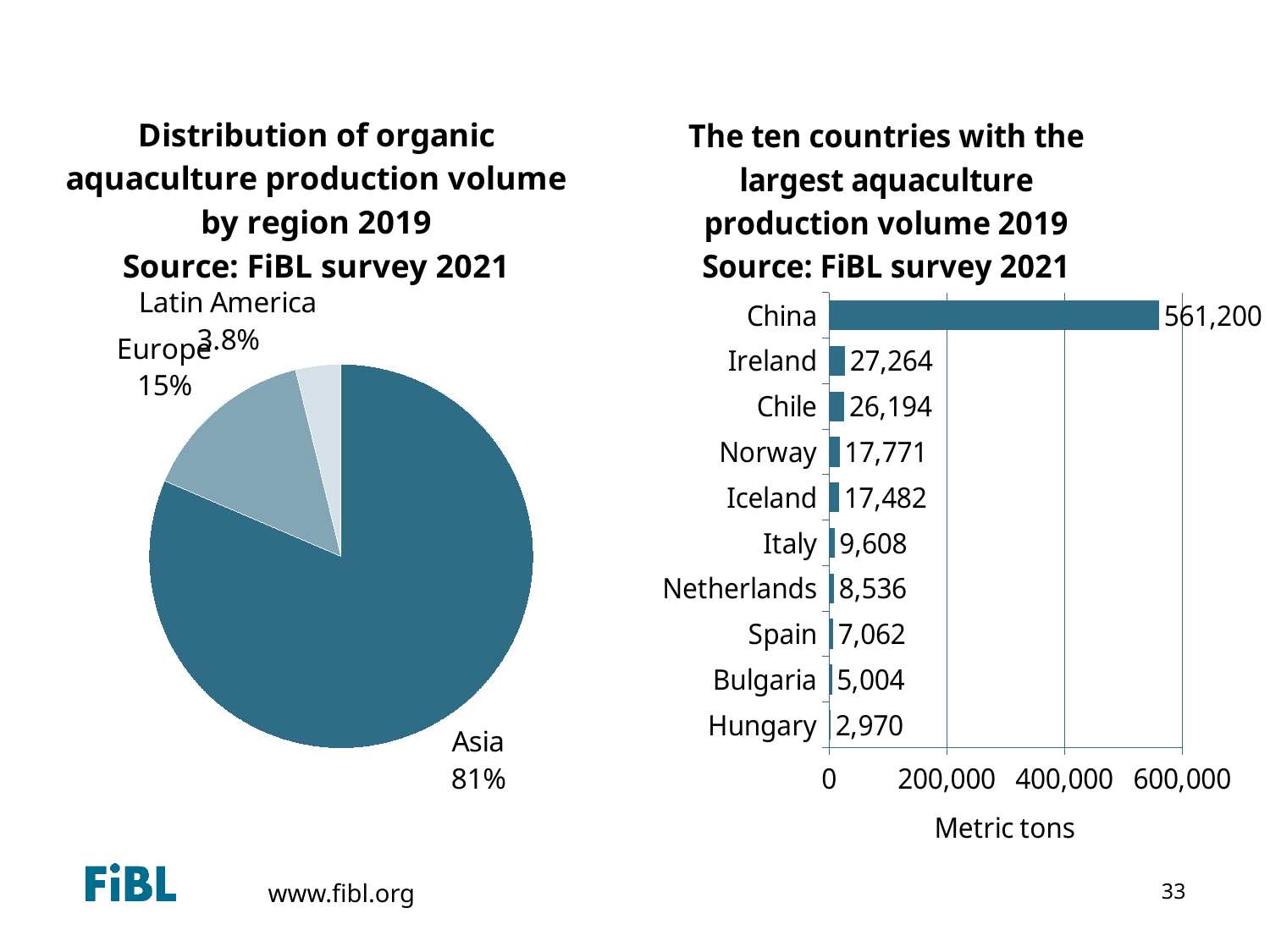
In the pie chart of the distribution of organic aquaculture production volume by region 2019, which region has the largest share? Asia What kind of chart is the chart on the right of the slide? Bar chart In the bar chart of the ten countries with the largest aquaculture production volume 2019, what is the difference between Ireland and Chile? 1,070 In the bar chart of the ten countries with the largest aquaculture production volume 2019, how many countries are shown? 10 In the bar chart of the ten countries with the largest aquaculture production volume 2019, what is the value for China? 561,200 In the bar chart of the ten countries with the largest aquaculture production volume 2019, which country has the lowest production volume? Hungary In the bar chart of the ten countries with the largest aquaculture production volume 2019, which is larger, Italy or Netherlands? Italy In the pie chart of the distribution of organic aquaculture production volume by region 2019, what share does Latin America have? 3.8% In the pie chart of the distribution of organic aquaculture production volume by region 2019, what share does Asia have? 81% In the bar chart of the ten countries with the largest aquaculture production volume 2019, what unit is shown on the x axis? Metric tons In the bar chart of the ten countries with the largest aquaculture production volume 2019, which country has the highest production volume? China In the bar chart of the ten countries with the largest aquaculture production volume 2019, what is the value for Norway? 17,771